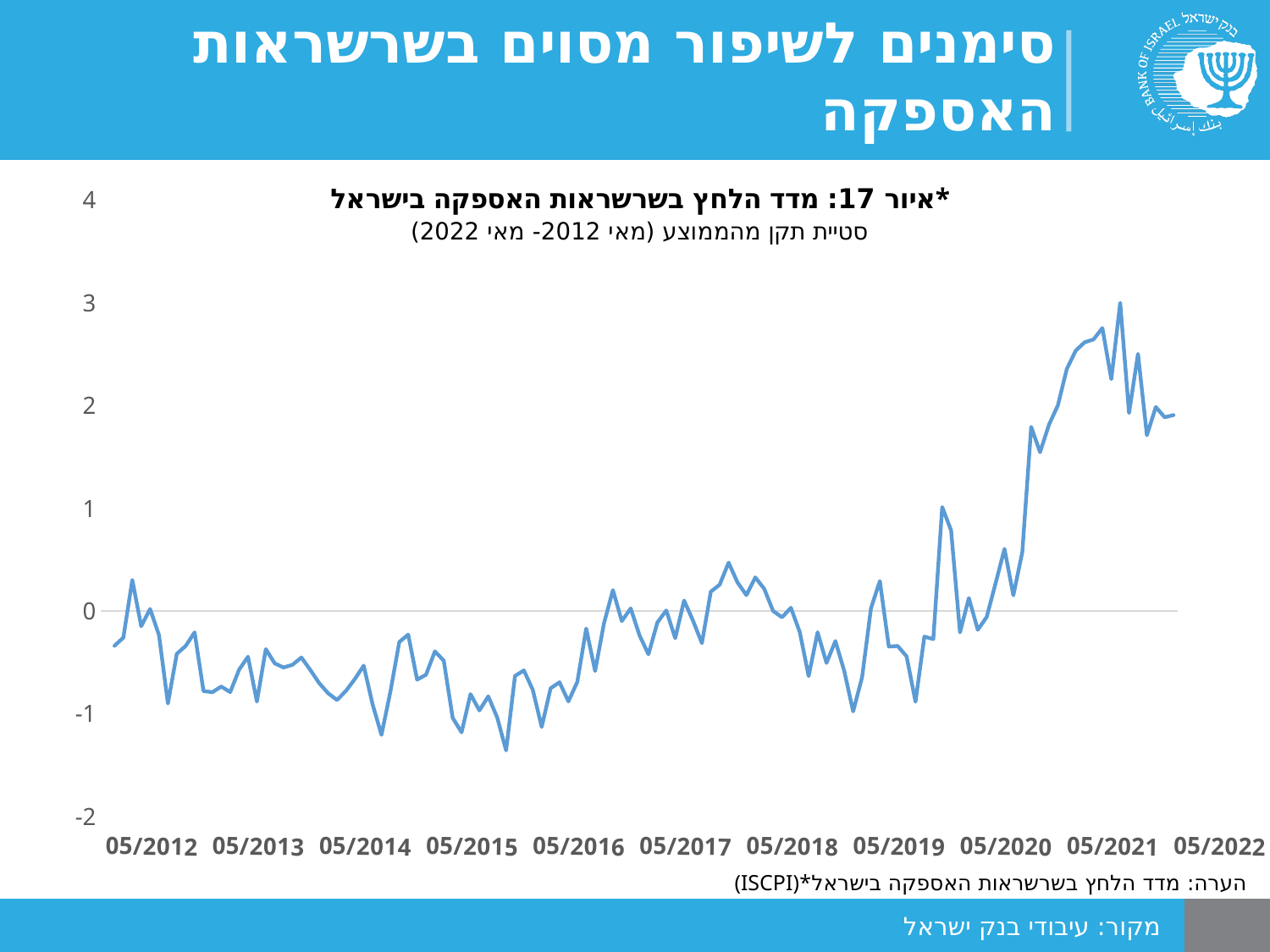
Is the value of the index at 05/2015 greater or less than 0? less Is the highest value reached by the line greater or less than 2? greater Is the value of the index at 05/2022 greater or less than 1? greater Overall, does the index rise or fall between 05/2012 and 05/2022? rise What kind of chart is shown on the slide? line chart How many date labels are shown along the x axis? 11 What is the range of the y axis, from lowest to highest tick? -2 to 4 In which year does the line reach its highest point? 2021 What is the title of the chart? *איור 17: מדד הלחץ בשרשראות האספקה בישראל